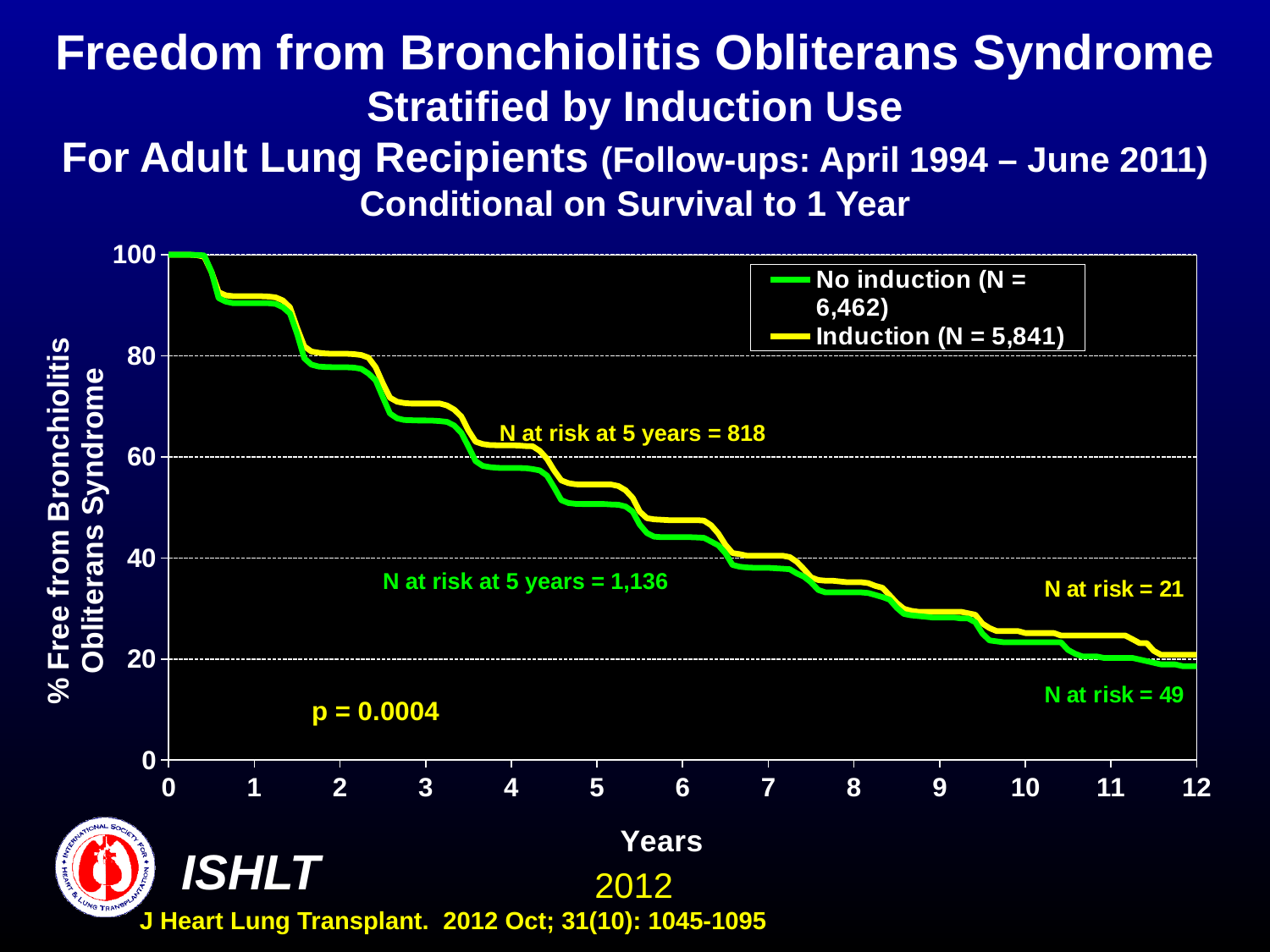
Is the value for the Induction curve at 10 years greater or less than 40? less What is the N at risk at 5 years for the No induction group? 1,136 Is the value for the No induction curve at 3 years greater or less than 60? greater What is the label of the y axis? % Free from Bronchiolitis Obliterans Syndrome What is the N for the Induction group shown in the legend? 5,841 What is the N at risk at 5 years for the Induction group? 818 How many series does the legend list? 2 What kind of chart is shown on the slide? line chart Which curve is higher at 5 years, Induction or No induction? Induction What p-value is printed on the chart? p = 0.0004 What is the N for the No induction group shown in the legend? 6,462 Do the curves rise or fall as years increase along the x axis? fall